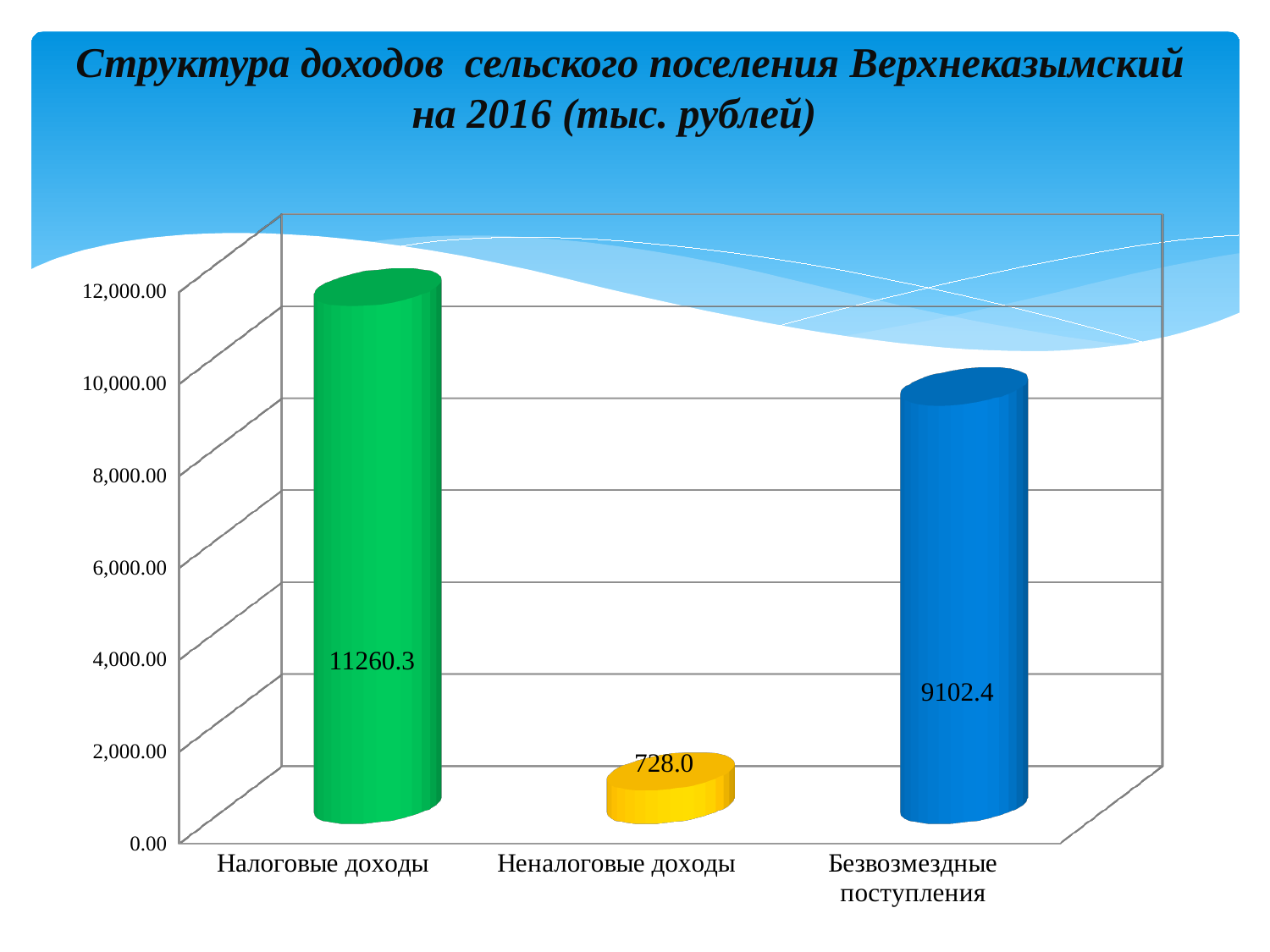
Which is larger, Налоговые доходы or Безвозмездные поступления? Налоговые доходы Which category has the highest value? Налоговые доходы What is the value for Налоговые доходы? 11260.3 What is the value for Неналоговые доходы? 728.0 What is the value for Безвозмездные поступления? 9102.4 What is the title of the chart? Структура доходов сельского поселения Верхнеказымский на 2016 (тыс. рублей) What is the difference between Налоговые доходы and Безвозмездные поступления? 2157.9 What is the difference between Безвозмездные поступления and Неналоговые доходы? 8374.4 What kind of chart is shown on the slide? Bar chart How many categories are shown on the chart? 3 Is the value for Безвозмездные поступления greater or less than 8,000.00? greater Which category has the lowest value? Неналоговые доходы